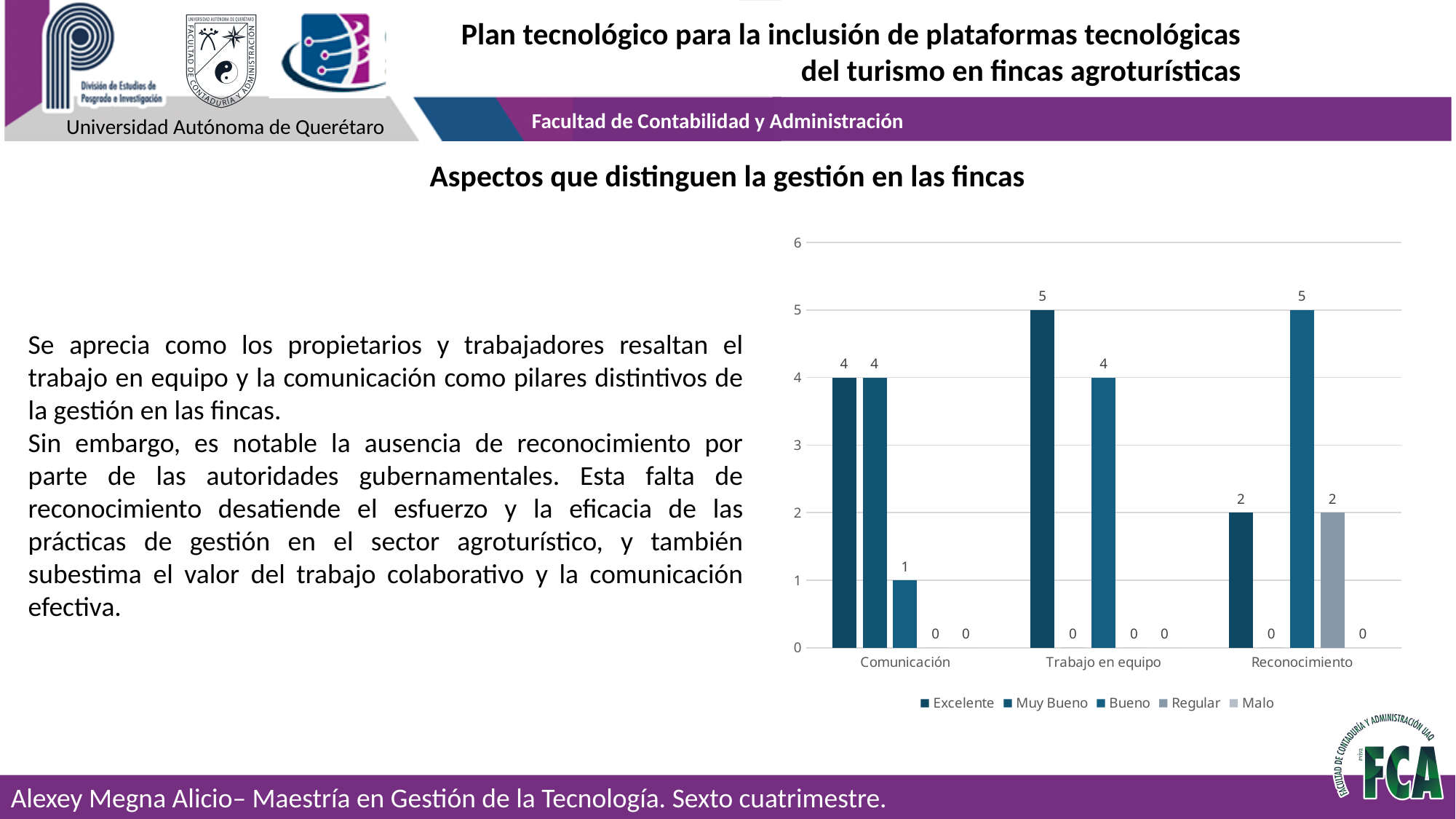
Which category has the lowest value for Excelente? Reconocimiento Which category has the highest value for Excelente? Trabajo en equipo How many categories are shown on the x axis? 3 What kind of chart is shown on the slide? Bar chart How many series does the legend list? 5 What is the value for Bueno in the Reconocimiento category? 5 Which is larger: the Excelente value for Comunicación or the Excelente value for Reconocimiento? Comunicación What is the value for Malo in the Trabajo en equipo category? 0 What is the difference between the Bueno value for Reconocimiento and the Bueno value for Comunicación? 4 What is the value for Regular in the Reconocimiento category? 2 What is the value for Excelente in the Trabajo en equipo category? 5 What is the value for Bueno in the Comunicación category? 1